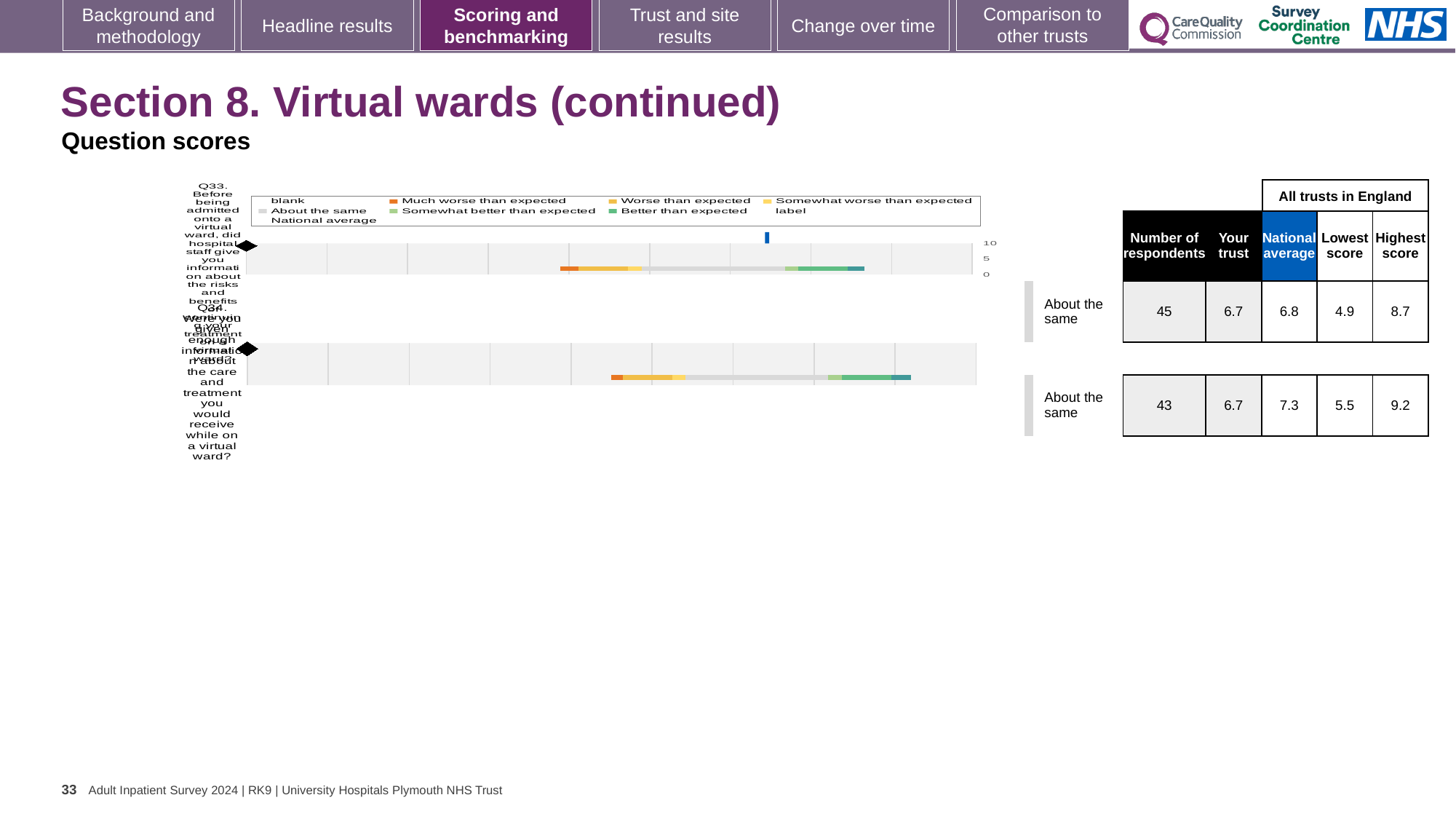
How many questions (categories) are plotted in the chart? 2 Is the 'Your trust' score for Q33 greater or less than 5? greater What is the 'Your trust' score for Q34? 6.7 What is the highest score among all trusts in England for Q34? 9.2 What is the number of respondents for Q33? 45 What is the national average score for Q33? 6.8 What kind of chart is used to show the question scores on this slide? bar chart Which legend entry is shown in light grey in the chart legend? About the same Which question has the higher national average, Q33 or Q34? Q34 Which legend entry is shown in orange in the chart legend? Much worse than expected What is the lowest score among all trusts in England for Q33? 4.9 What is the difference between the national average and the 'Your trust' score for Q34? 0.6